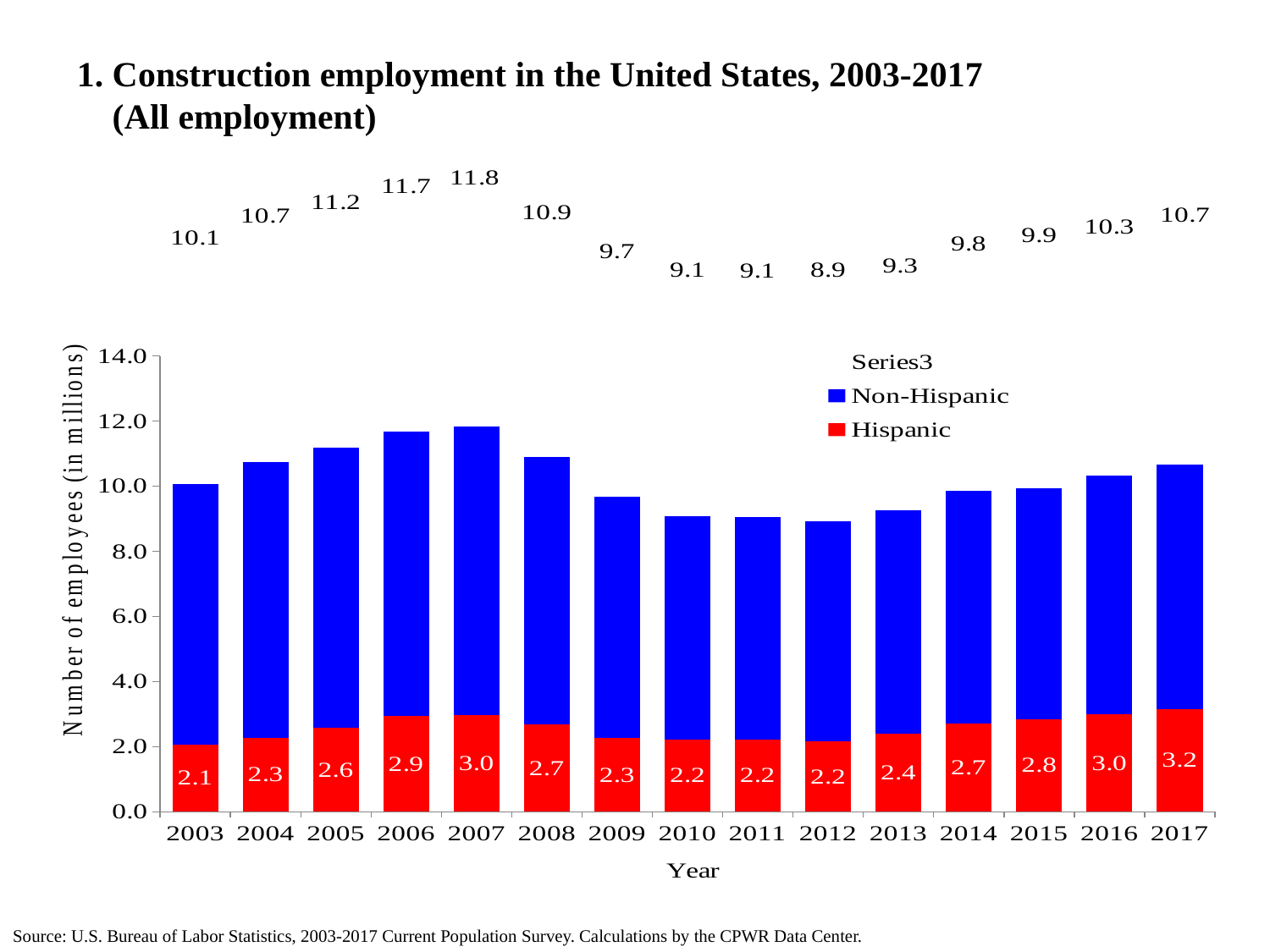
What kind of chart is shown on the slide? Stacked bar chart Which year has the highest total construction employment? 2007 What is the difference between the Hispanic value for 2017 and the Hispanic value for 2003? 1.1 Which year has the larger total, 2006 or 2016? 2006 What is the difference between the total for 2007 and the total for 2012? 2.9 Which year has the highest Hispanic value? 2017 Which year has the lowest total construction employment? 2012 What is the Hispanic value for 2007? 3.0 How many years are shown on the x axis? 15 Do the total values rise or fall from 2003 to 2007? Rise What is the total construction employment shown for 2012? 8.9 What is the Hispanic value for 2013? 2.4